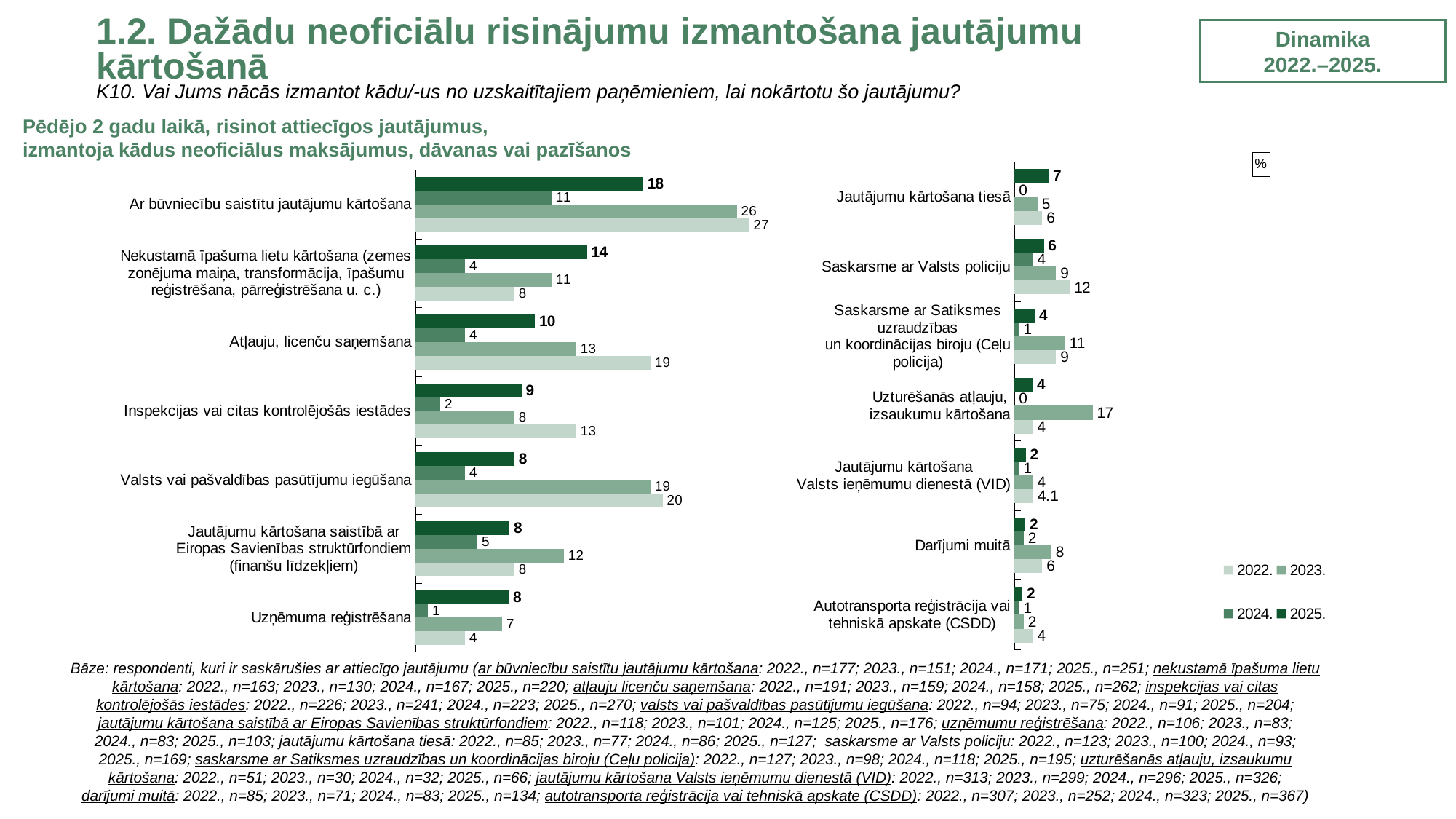
In the left chart, what is the 2022 value for 'Atļauju, licenču saņemšana'? 19 How many series does the legend list? 4 In the left chart, which category has the highest 2025 value? Ar būvniecību saistītu jautājumu kārtošana In the right chart, what is the 2022 value for 'Jautājumu kārtošana Valsts ieņēmumu dienestā (VID)'? 4.1 In the left chart, what is the 2025 value for 'Ar būvniecību saistītu jautājumu kārtošana'? 18 In the left chart, what is the difference between the 2022 and 2025 values for 'Valsts vai pašvaldības pasūtījumu iegūšana'? 12 What kind of chart is used on this slide? Bar chart How many categories does the left chart show? 7 In the right chart, what is the 2024 value for 'Jautājumu kārtošana tiesā'? 0 In the right chart, which category has the lowest 2023 value? Autotransporta reģistrācija vai tehniskā apskate (CSDD) In the right chart, what is the 2023 value for 'Uzturēšanās atļauju, izsaukumu kārtošana'? 17 In the right chart, which is larger for 'Saskarsme ar Valsts policiju': the 2022 value or the 2025 value? 2022